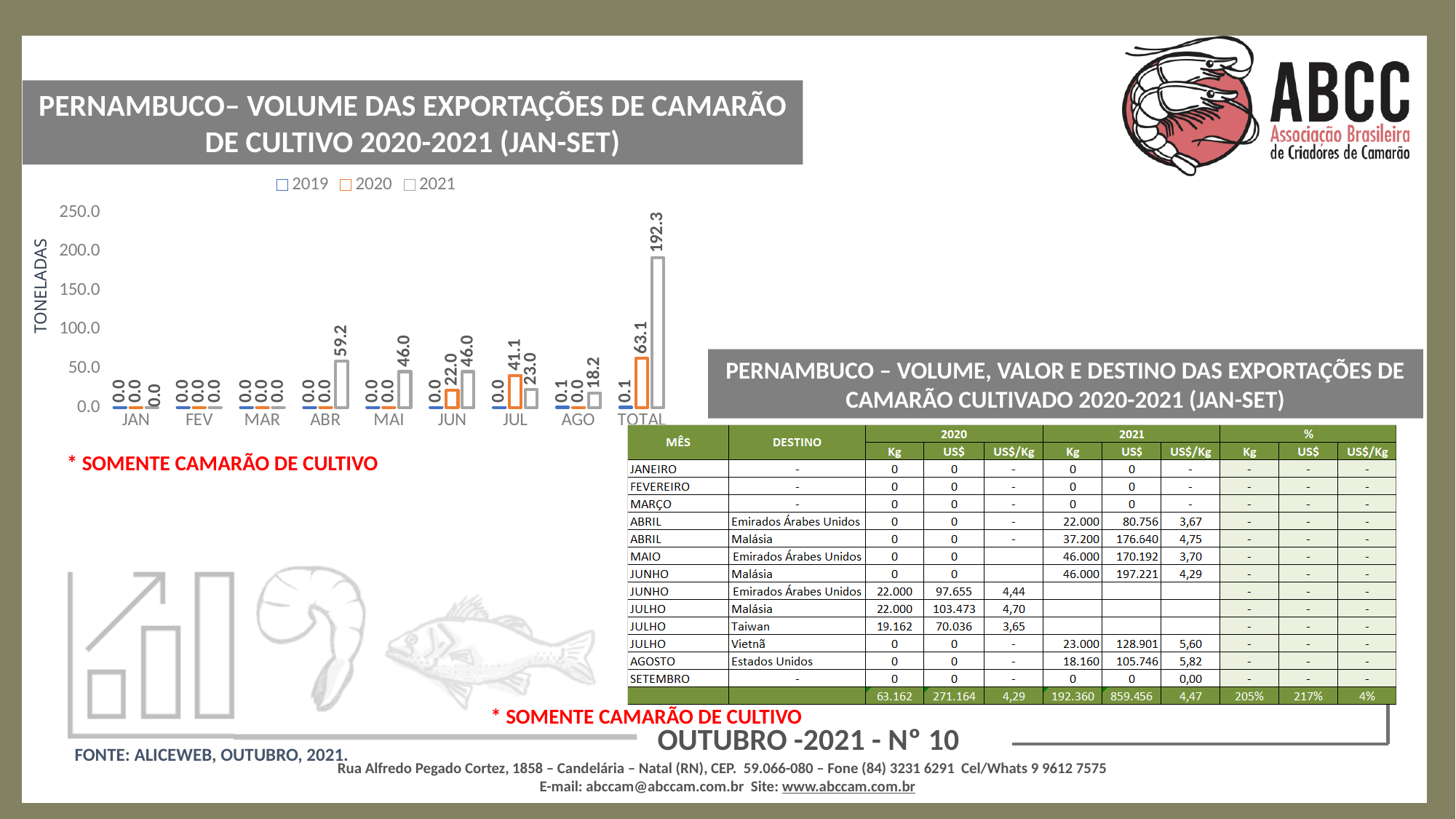
Which month (excluding TOTAL) has the highest 2021 value in the chart? ABR What kind of chart is shown on the slide? bar chart How many series does the chart legend list? 3 What is the 2020 value for JUL in the chart? 41.1 What is the 2021 value for TOTAL in the chart? 192.3 What is the 2020 value for TOTAL in the chart? 63.1 How many categories are shown on the x axis of the chart? 9 What is the 2021 value for ABR in the chart? 59.2 In the chart, which is larger for JUN: the 2020 value or the 2021 value? 2021 What is the difference between the 2020 and 2021 values for JUL in the chart? 18.1 Is the 2021 value for TOTAL in the chart greater or less than 150.0? greater What is the difference between the 2021 and 2020 values for TOTAL in the chart? 129.2